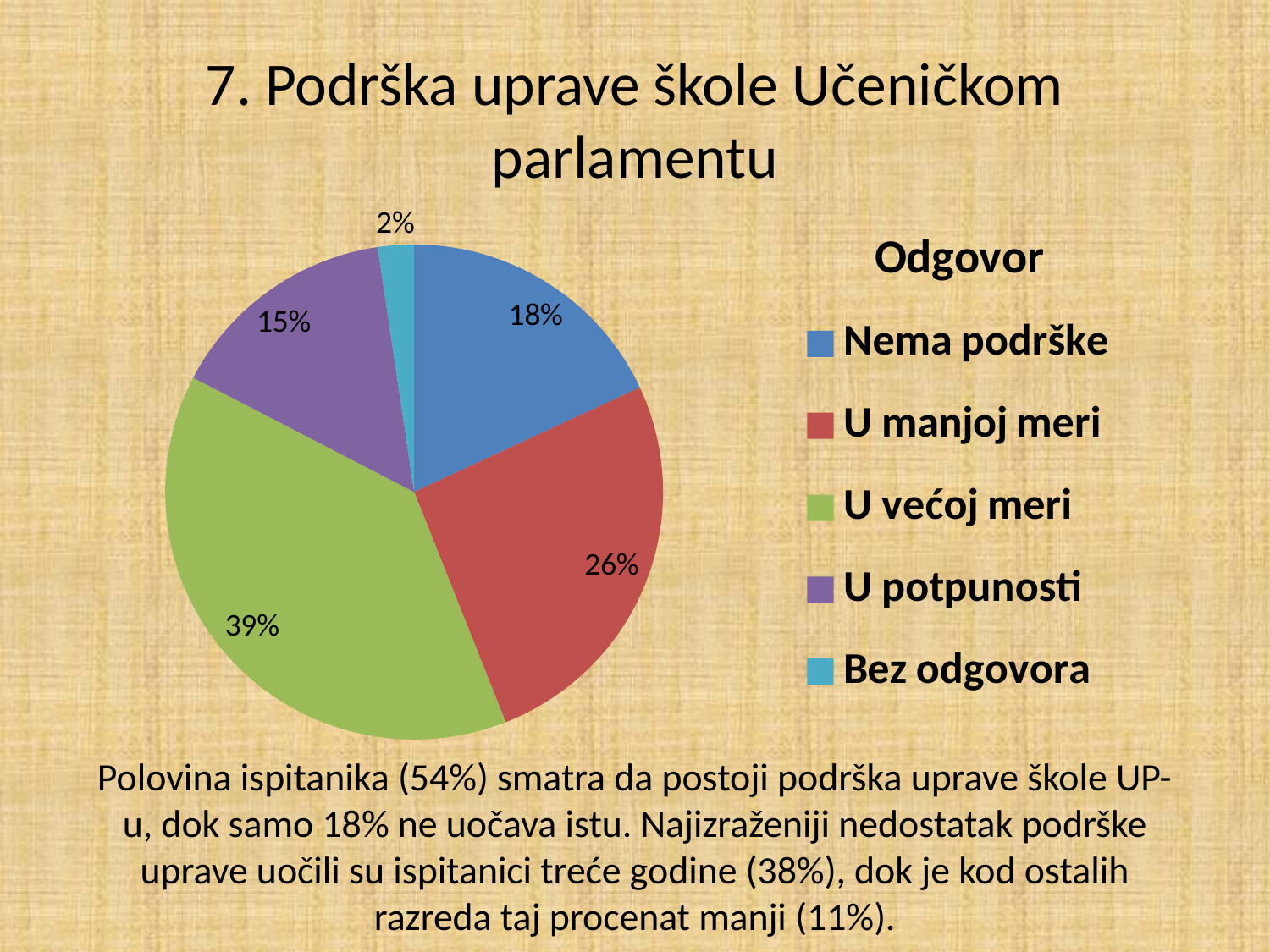
Which slice is larger, "Nema podrške" or "U potpunosti"? Nema podrške What percentage of the pie is labelled "U potpunosti"? 15% Which category has the largest slice of the pie? U većoj meri How many slices does the pie chart have? 5 Which category has the smallest slice of the pie? Bez odgovora What percentage of the pie is labelled "U većoj meri"? 39% What percentage of the pie is labelled "Bez odgovora"? 2% What is the difference in percentage points between "U većoj meri" and "U manjoj meri"? 13 What percentage of the pie is labelled "U manjoj meri"? 26% What percentage of the pie is labelled "Nema podrške"? 18% What kind of chart is shown on the slide? Pie chart What is the title of the legend on the chart? Odgovor